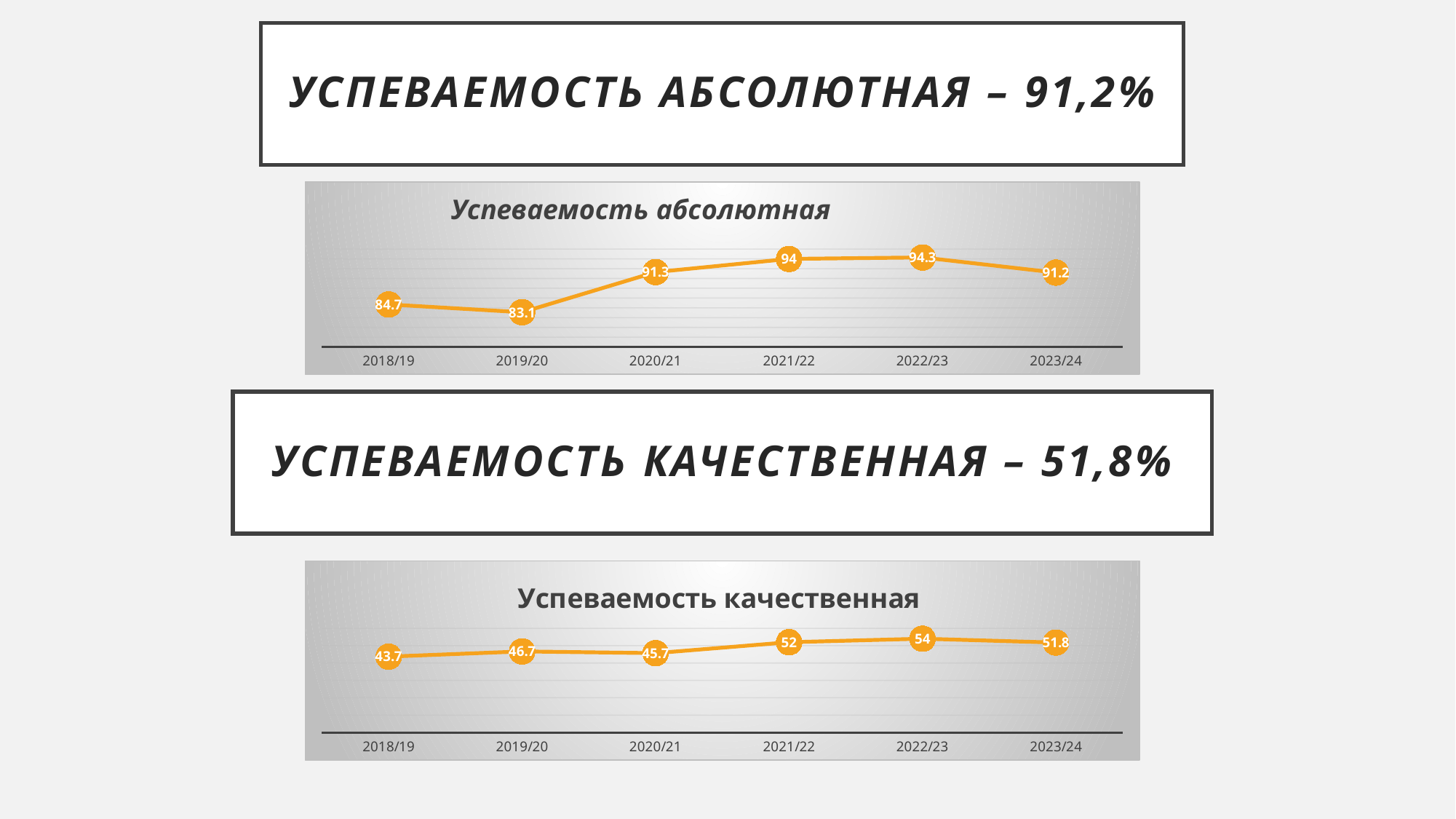
In the chart titled "Успеваемость качественная", what is the value for 2021/22? 52 In the chart titled "Успеваемость абсолютная", what is the value for 2019/20? 83.1 In the chart titled "Успеваемость качественная", which year has the lowest value? 2018/19 In the chart titled "Успеваемость абсолютная", how many data points are plotted? 6 In the chart titled "Успеваемость абсолютная", which year has the lowest value? 2019/20 In the chart titled "Успеваемость качественная", which is larger: the value for 2019/20 or the value for 2020/21? 2019/20 In the chart titled "Успеваемость абсолютная", does the value rise or fall from 2019/20 to 2020/21? rise In the chart titled "Успеваемость абсолютная", what is the difference between the values for 2022/23 and 2023/24? 3.1 What kind of chart is the chart titled "Успеваемость абсолютная"? line chart In the chart titled "Успеваемость качественная", what is the difference between the values for 2022/23 and 2018/19? 10.3 In the chart titled "Успеваемость качественная", which year has the highest value? 2022/23 In the chart titled "Успеваемость абсолютная", which year has the highest value? 2022/23